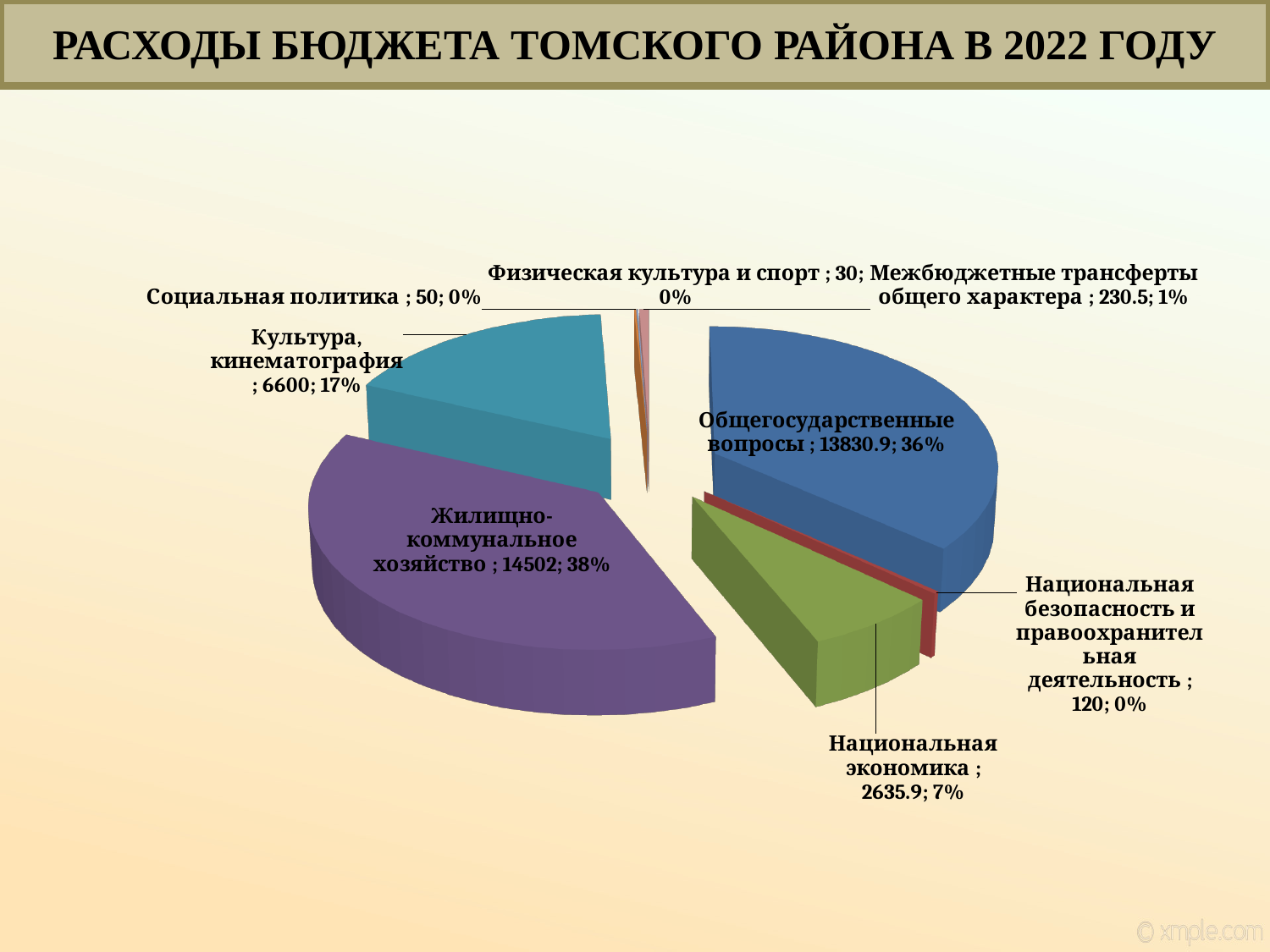
What kind of chart is shown on the slide? Pie chart Which category has the largest value? Жилищно-коммунальное хозяйство What is the value for Национальная экономика? 2635.9 Which category has the smallest value? Физическая культура и спорт What is the value for Жилищно-коммунальное хозяйство? 14502 What share of the pie does Общегосударственные вопросы represent? 36% What share of the pie does Культура, кинематография represent? 17% How many categories are shown in the pie chart? 8 What is the value for Общегосударственные вопросы? 13830.9 What is the difference between the values for Жилищно-коммунальное хозяйство and Общегосударственные вопросы? 671.1 What is the value for Межбюджетные трансферты общего характера? 230.5 Which is larger, the value for Культура, кинематография or the value for Национальная экономика? Культура, кинематография